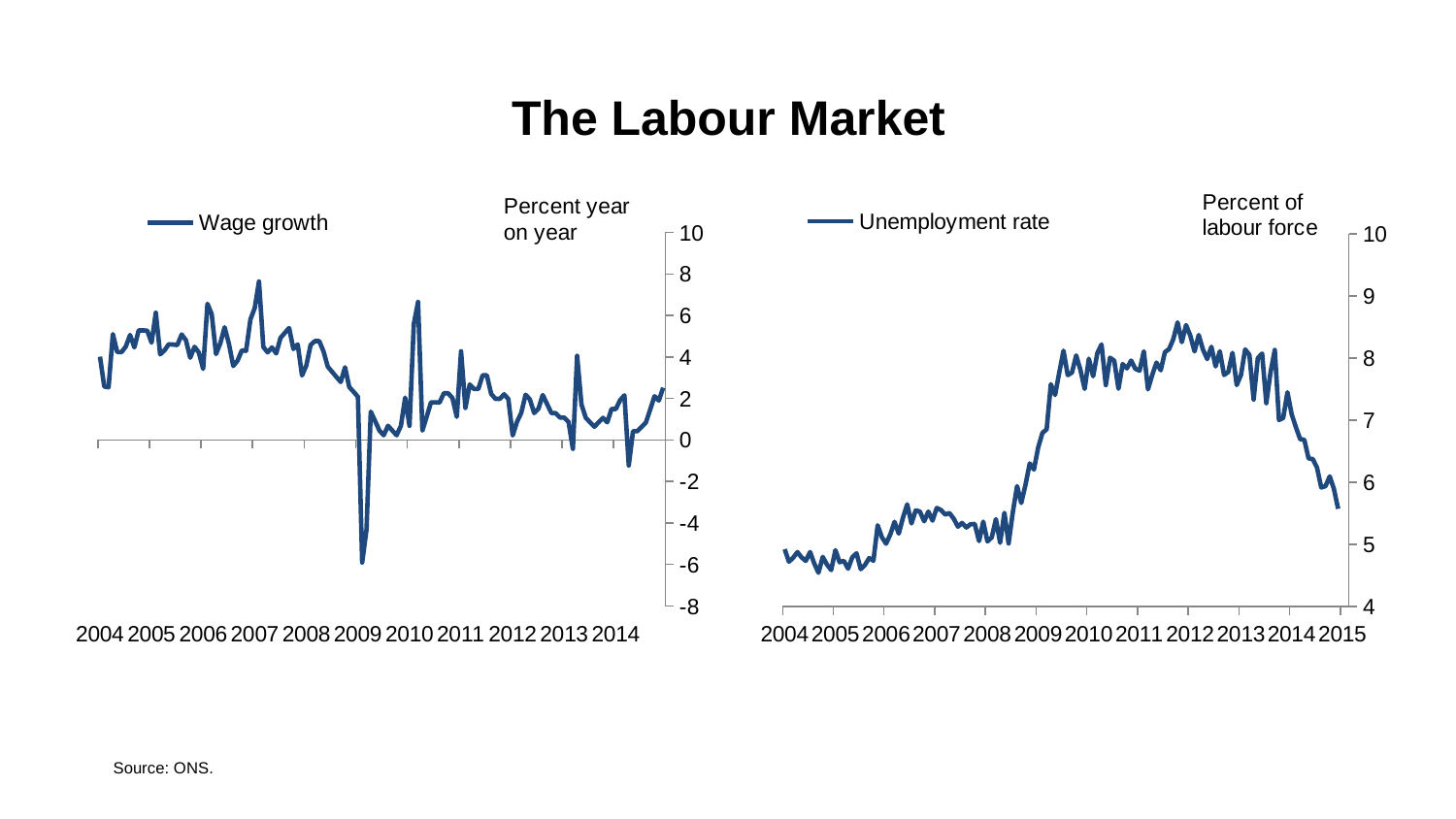
How many year labels are shown on the x axis of the Unemployment rate chart? 12 In the Unemployment rate chart, does the line rise or fall between 2008 and 2010? rise In the Unemployment rate chart, is the peak value around 2012 greater or less than 8? greater How many series does the legend of the Wage growth chart list? 1 How many series does the legend of the Unemployment rate chart list? 1 What unit label is shown above the y axis of the Unemployment rate chart? Percent of labour force In the Wage growth chart, is the lowest value of the line, reached in 2009, greater or less than -4? less What kind of chart is the Wage growth chart on the left? line chart What kind of chart is the Unemployment rate chart on the right? line chart In the Unemployment rate chart, does the line rise or fall between 2012 and 2015? fall In the Wage growth chart, is the highest value of the line, reached around 2007, greater or less than 6? greater